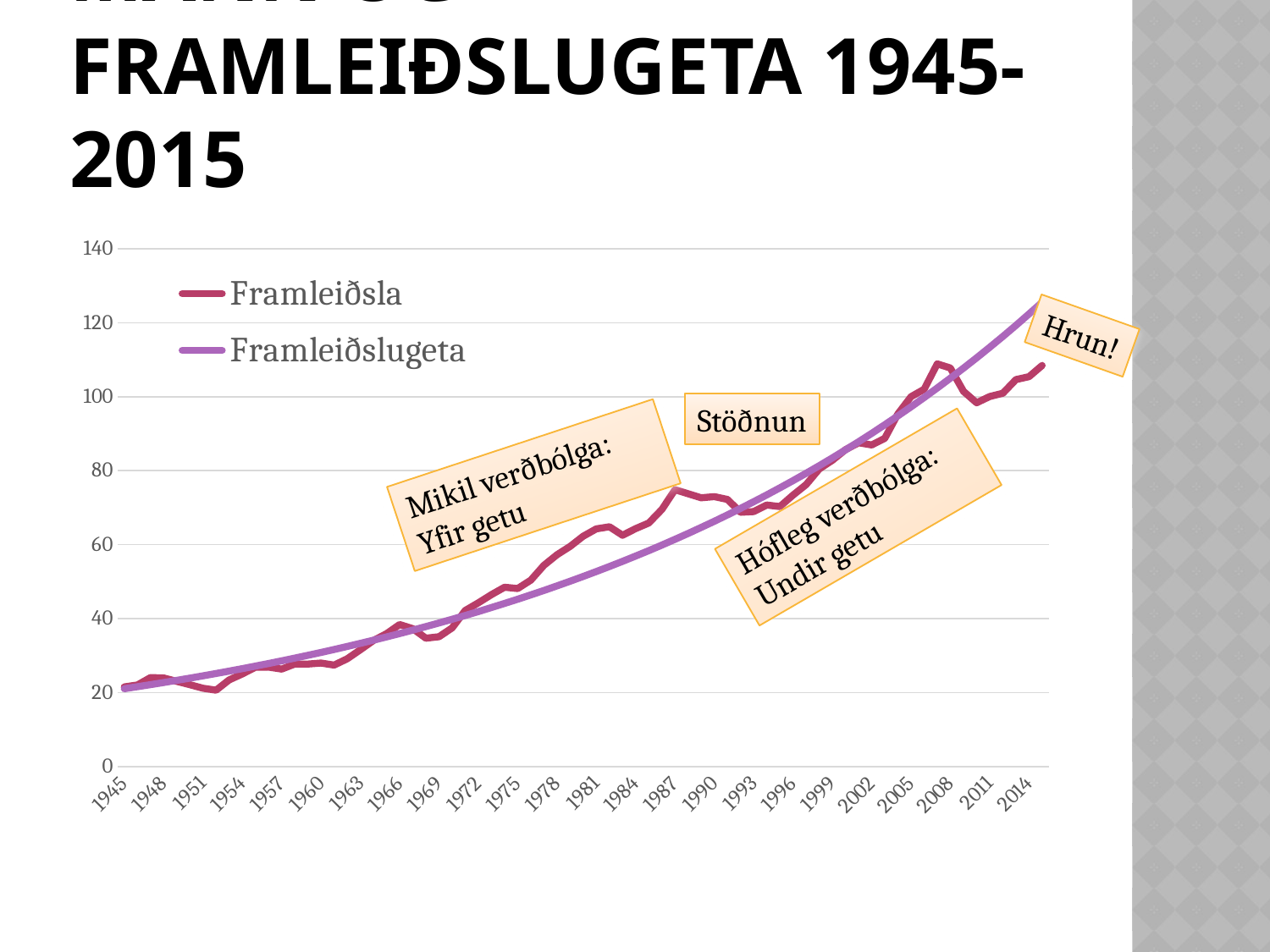
Is the value of Framleiðsla in 2008 greater or less than 100? greater Is the value of Framleiðsla in 1987 greater or less than 60? greater How many series does the legend list? 2 Does the Framleiðslugeta line rise or fall from 1945 to 2014? Rises What does the annotation box at the top right of the chart say? Hrun! Is the value of Framleiðsla in 1960 greater or less than 40? less In 2014, which series has the higher value, Framleiðsla or Framleiðslugeta? Framleiðslugeta In 1987, which series has the higher value, Framleiðsla or Framleiðslugeta? Framleiðsla What kind of chart is shown on the slide? Line chart How many year labels are shown on the x axis? 24 What are the two series named in the legend? Framleiðsla and Framleiðslugeta